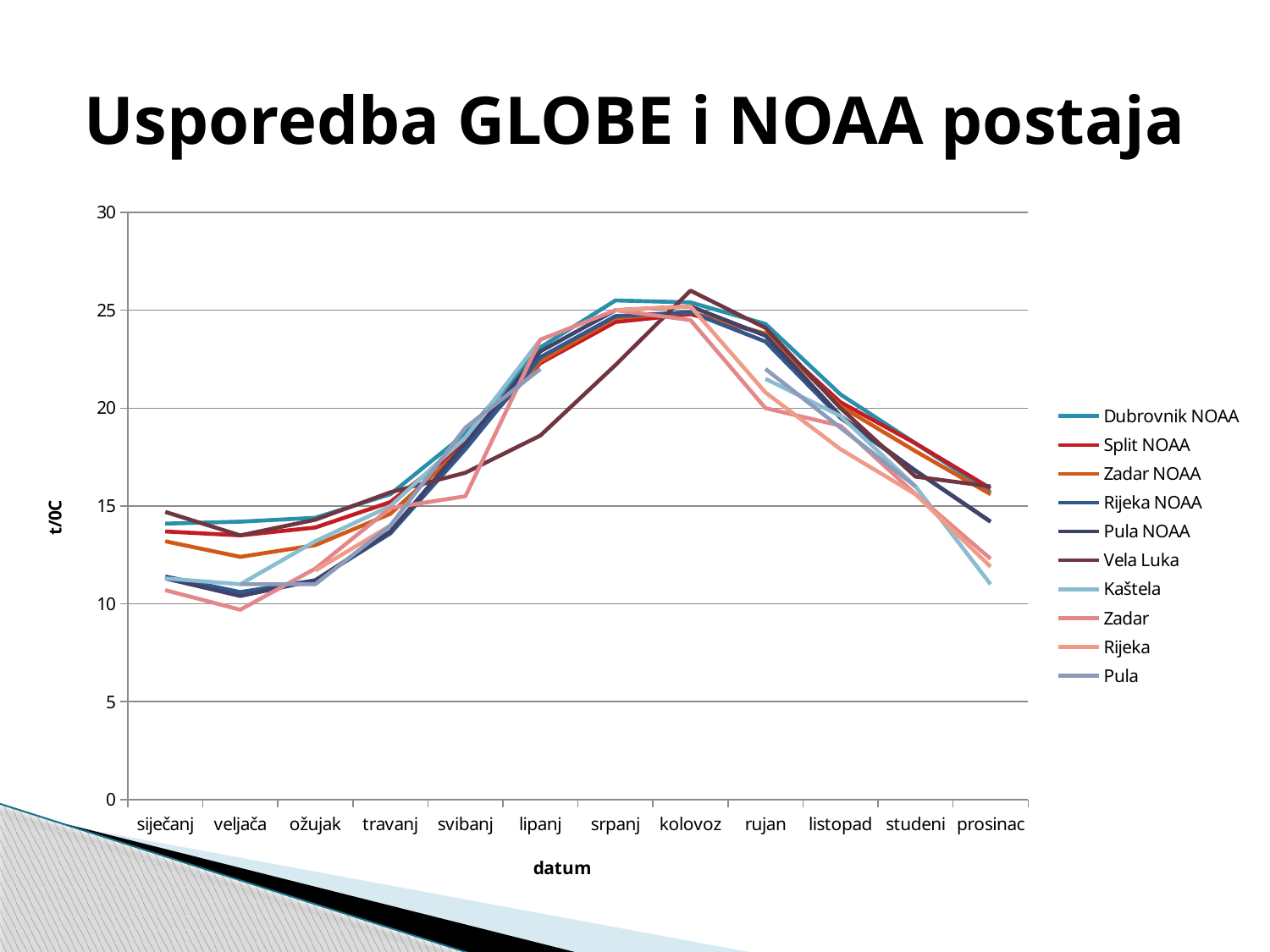
In which month does Vela Luka reach its highest value? kolovoz What is the label of the x axis? datum How many months are shown along the x axis? 12 Is the value for Vela Luka in lipanj greater or less than 20? less Which series has the highest value in kolovoz? Vela Luka Is the value for Vela Luka in kolovoz greater or less than 25? greater Is the value for Dubrovnik NOAA in siječanj greater or less than 10? greater Do the values for Dubrovnik NOAA rise or fall from kolovoz to prosinac? fall What is the title of the slide? Usporedba GLOBE i NOAA postaja What kind of chart is shown on the slide? line chart How many series does the legend list? 10